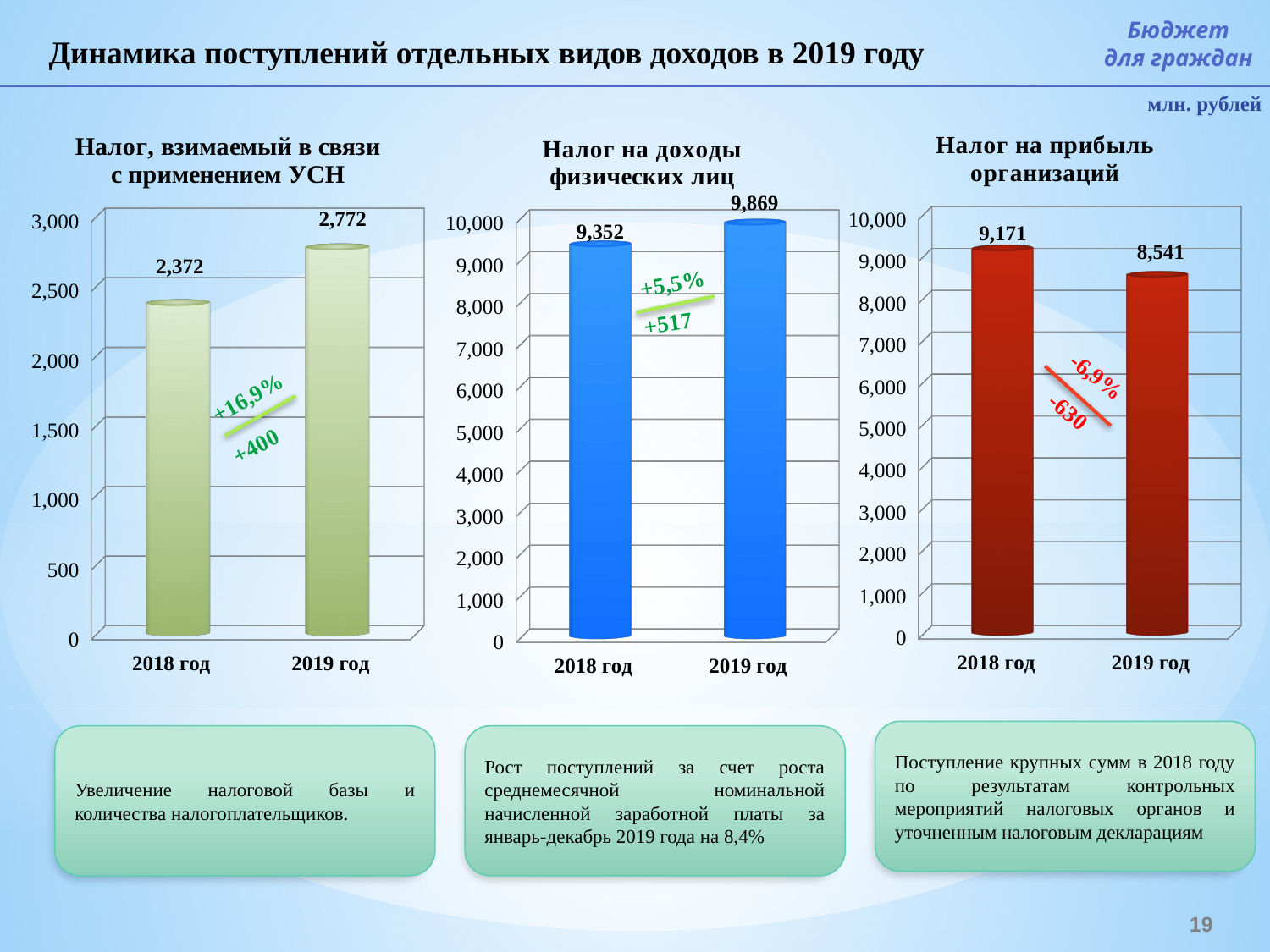
What kind of chart is the chart titled "Налог на доходы физических лиц"? bar chart In the chart titled "Налог, взимаемый в связи с применением УСН", what is the value for 2019 год? 2,772 In the chart titled "Налог на прибыль организаций", do the values rise or fall from 2018 год to 2019 год? fall In the chart titled "Налог на прибыль организаций", what is the value for 2019 год? 8,541 In the chart titled "Налог на прибыль организаций", what is the value for 2018 год? 9,171 In the chart titled "Налог на доходы физических лиц", which year has the higher value? 2019 год In the chart titled "Налог, взимаемый в связи с применением УСН", what is the value for 2018 год? 2,372 In the chart titled "Налог на доходы физических лиц", what is the value for 2019 год? 9,869 How many charts are shown on the slide? 3 In the chart titled "Налог на доходы физических лиц", what is the value for 2018 год? 9,352 In the chart titled "Налог, взимаемый в связи с применением УСН", what is the difference between the 2019 год and 2018 год values? 400 In the chart titled "Налог на прибыль организаций", by how much did the value decrease from 2018 год to 2019 год? 630